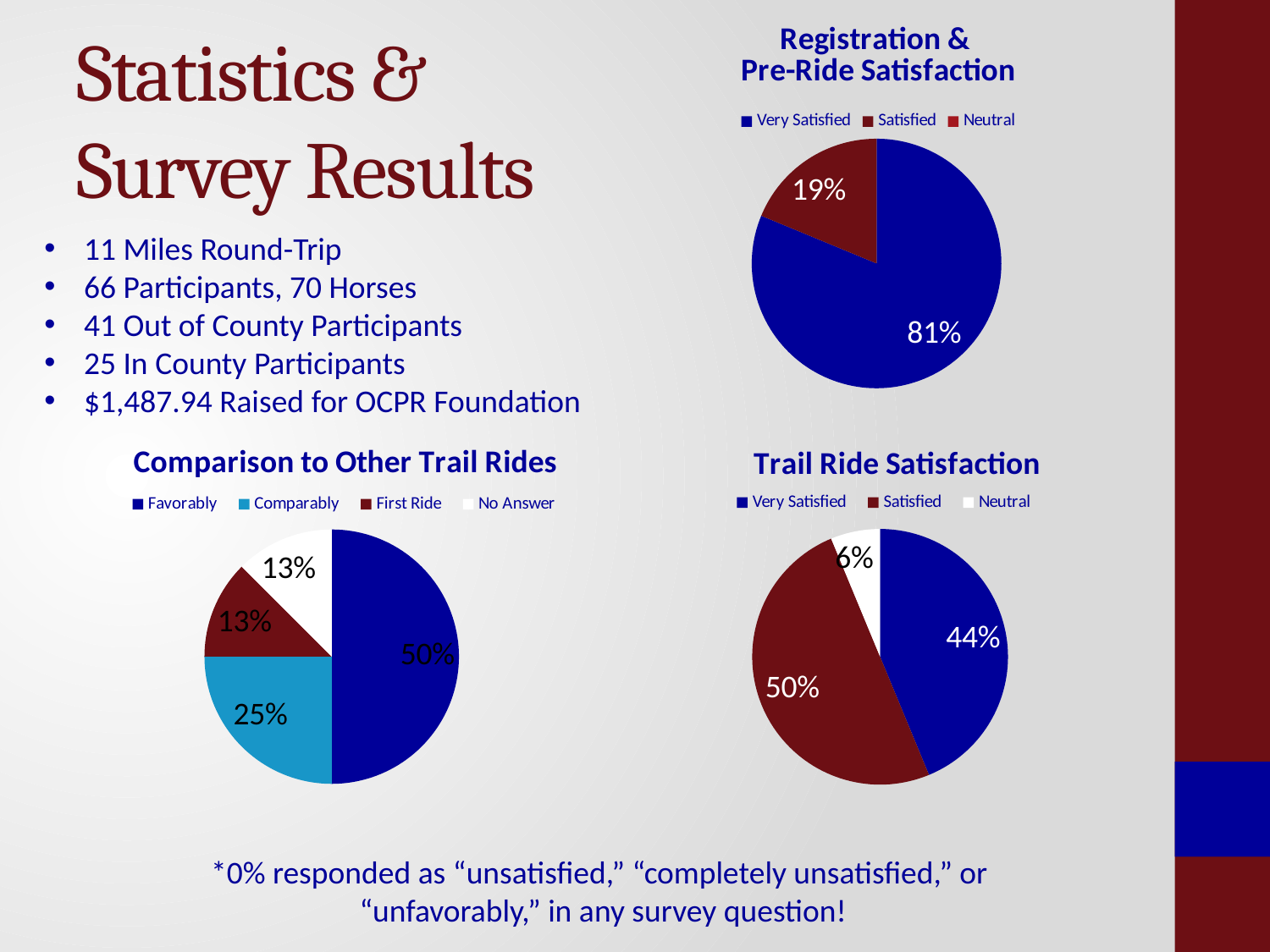
In the Comparison to Other Trail Rides chart, what is the difference between the Favorably and Comparably shares? 25% In the Registration & Pre-Ride Satisfaction chart, what share of respondents were Very Satisfied? 81% In the Registration & Pre-Ride Satisfaction chart, what share of respondents were Satisfied? 19% In the Comparison to Other Trail Rides chart, what share of respondents answered Favorably? 50% In the Comparison to Other Trail Rides chart, how many categories does the legend list? 4 In the Registration & Pre-Ride Satisfaction chart, how many entries does the legend list? 3 What kind of chart is the Comparison to Other Trail Rides chart? Pie chart In the Trail Ride Satisfaction chart, which is larger: the Very Satisfied share or the Satisfied share? Satisfied In the Comparison to Other Trail Rides chart, which category has the largest slice? Favorably In the Trail Ride Satisfaction chart, which category has the smallest slice? Neutral